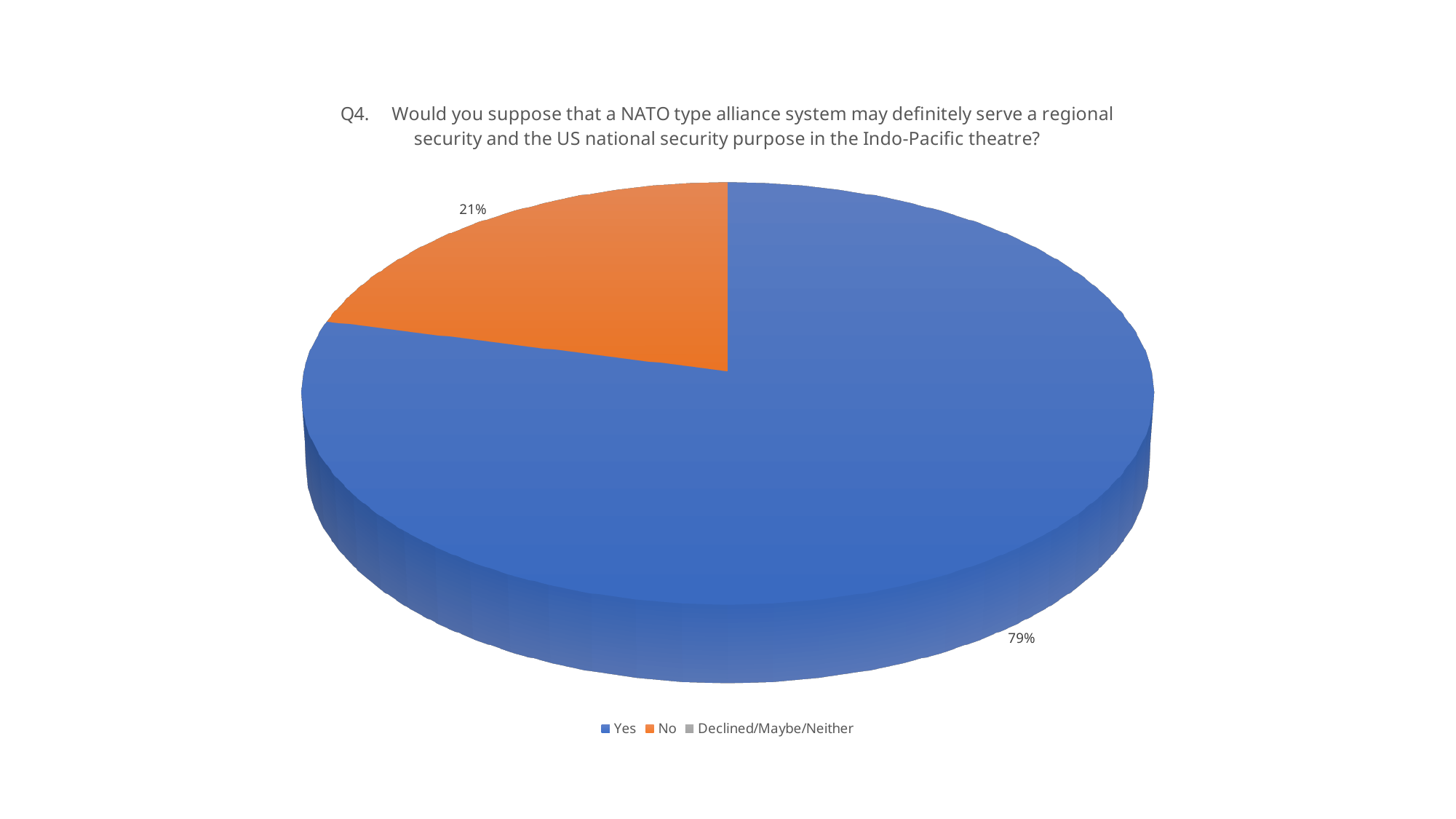
What share of the pie does the Yes slice represent? 79% Is the share for No greater or less than 25%? less Which category has the largest slice of the pie? Yes How many categories does the legend list? 3 Is the share for Yes greater or less than 75%? greater Which legend entry has no visible slice in the pie? Declined/Maybe/Neither What kind of chart is shown on the slide? pie chart What share of the pie does the No slice represent? 21% What colour is the Yes slice? blue Which of the two visible slices is larger, Yes or No? Yes What is the difference in percentage points between the Yes and No slices? 58